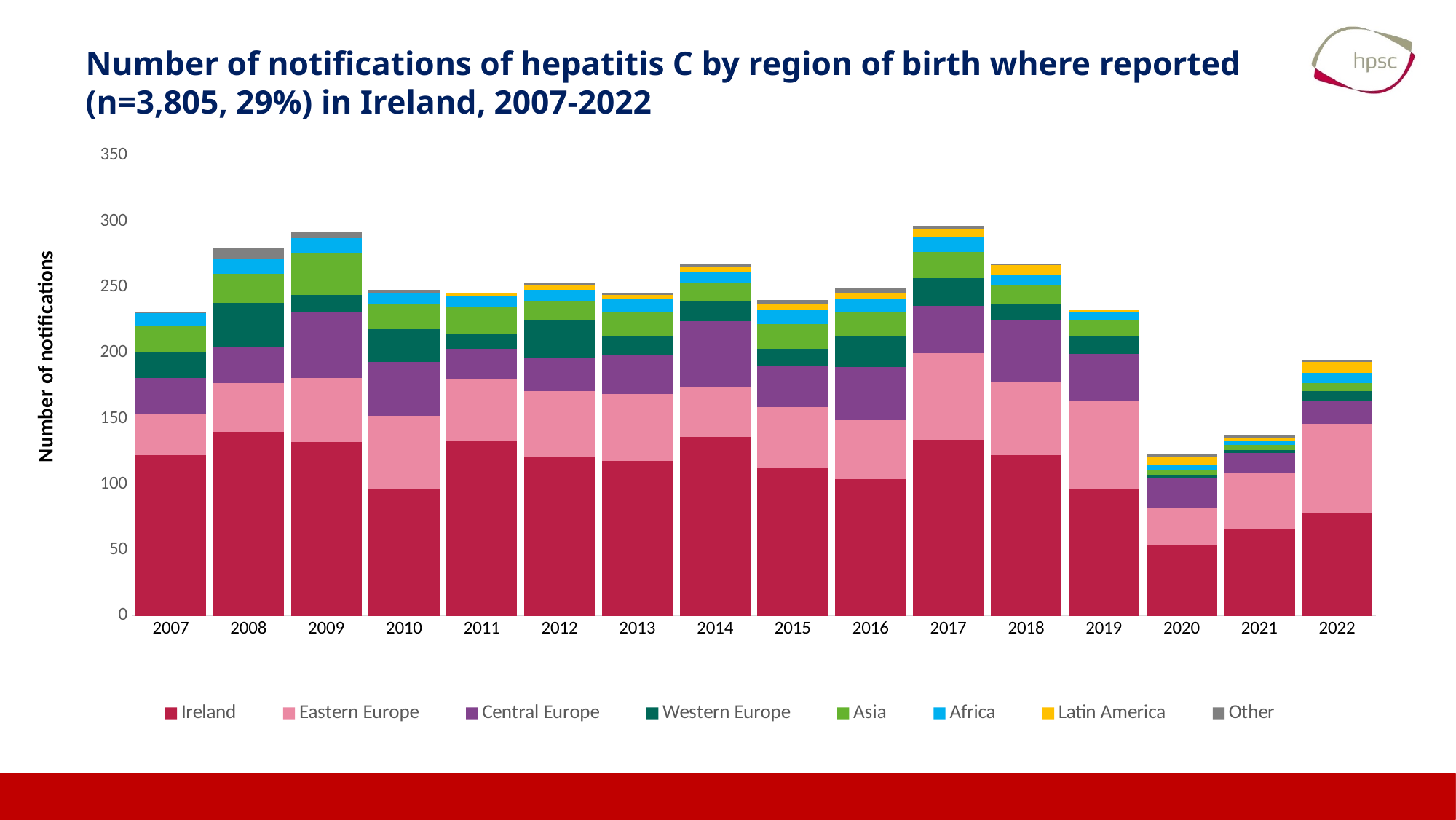
How many regions of birth does the legend list? 8 Is the number of notifications for Ireland in 2020 greater or less than 100? less What kind of chart is shown on the slide? Stacked bar chart Is the total number of notifications in 2020 greater or less than 150? less Which year has the lowest total number of notifications? 2020 Do total notifications rise or fall from 2019 to 2020? fall What is the label on the y axis of the chart? Number of notifications Which region of birth is listed first in the legend? Ireland Which year has the larger total number of notifications, 2007 or 2008? 2008 How many years are shown along the x axis of the chart? 16 Is the total number of notifications in 2017 greater or less than 250? greater